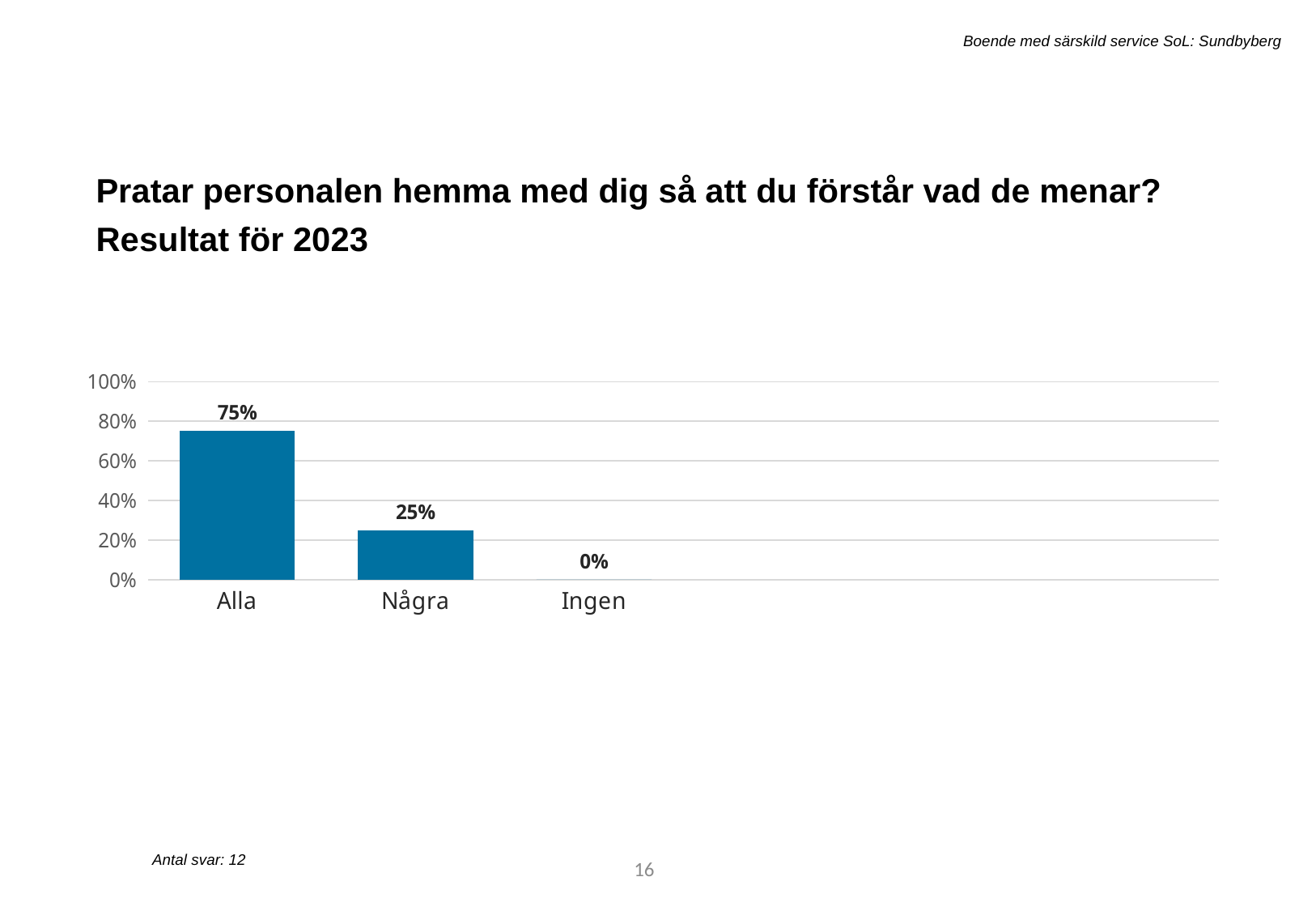
What is the difference between the values for Alla and Några? 50% Which is larger, the value for Några or the value for Ingen? Några What is the value for Några? 25% Is the value for Alla greater or less than 60%? greater What kind of chart is shown on the slide? bar chart Do the values rise or fall from left to right along the x axis? fall What is the number of responses (Antal svar) stated on the slide? 12 How many categories are shown on the x axis? 3 Which category has the lowest value? Ingen Which category has the highest value? Alla What is the value for Ingen? 0% What is the value for Alla? 75%